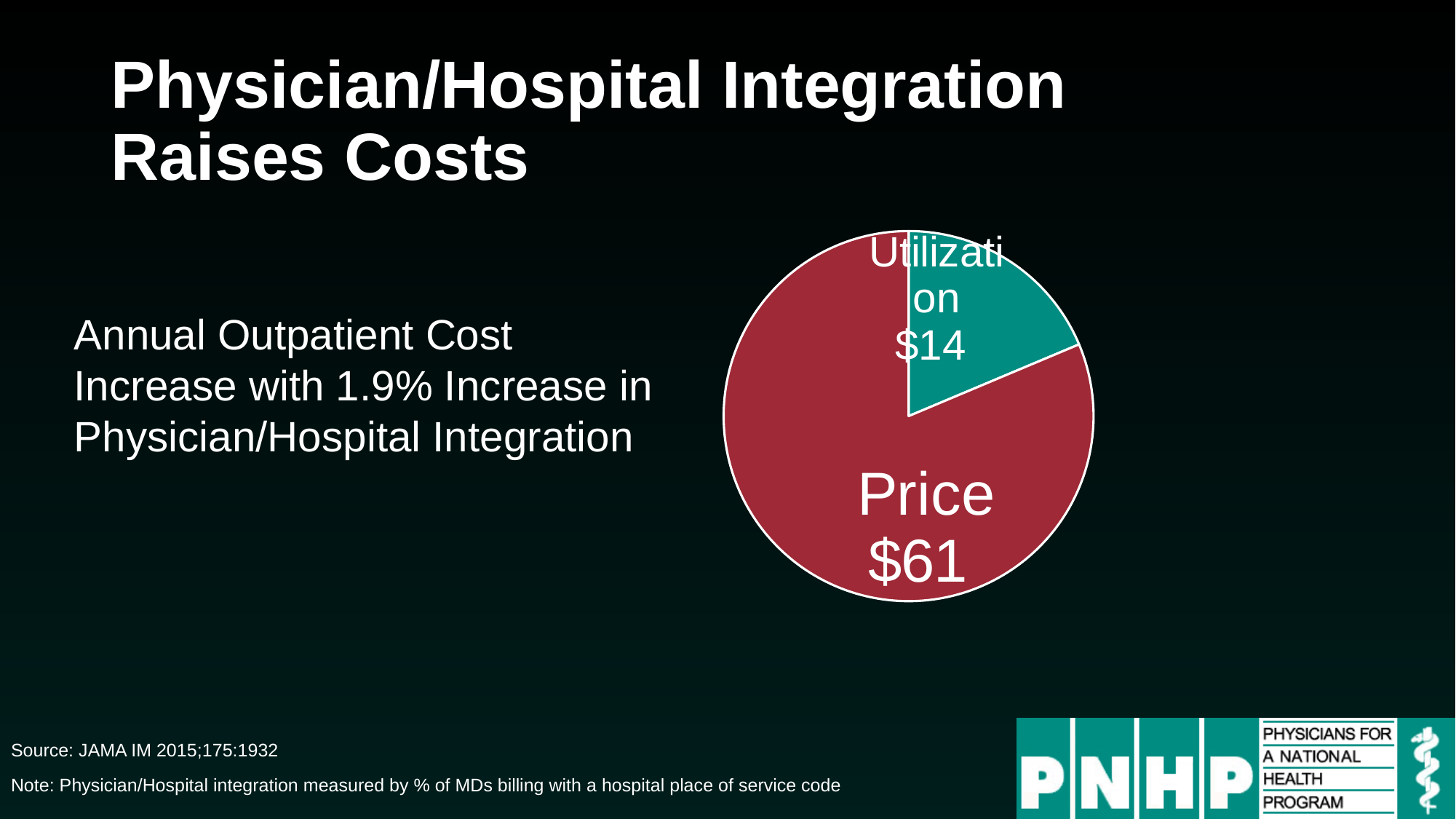
What is the value of the Price slice in the pie chart? $61 Which slice of the pie chart is the smallest? Utilization What is the difference between the Price and Utilization values in the pie chart? $47 What colour is the Utilization slice in the pie chart? teal What colour is the Price slice in the pie chart? red What is the value of the Utilization slice in the pie chart? $14 What share of the pie chart total does the Price slice represent, to the nearest whole percent? 81% Which slice of the pie chart is the largest? Price What type of chart is shown on the slide? pie chart How many slices does the pie chart have? 2 Which is larger in the pie chart, Price or Utilization? Price What is the total of the two slices in the pie chart? $75